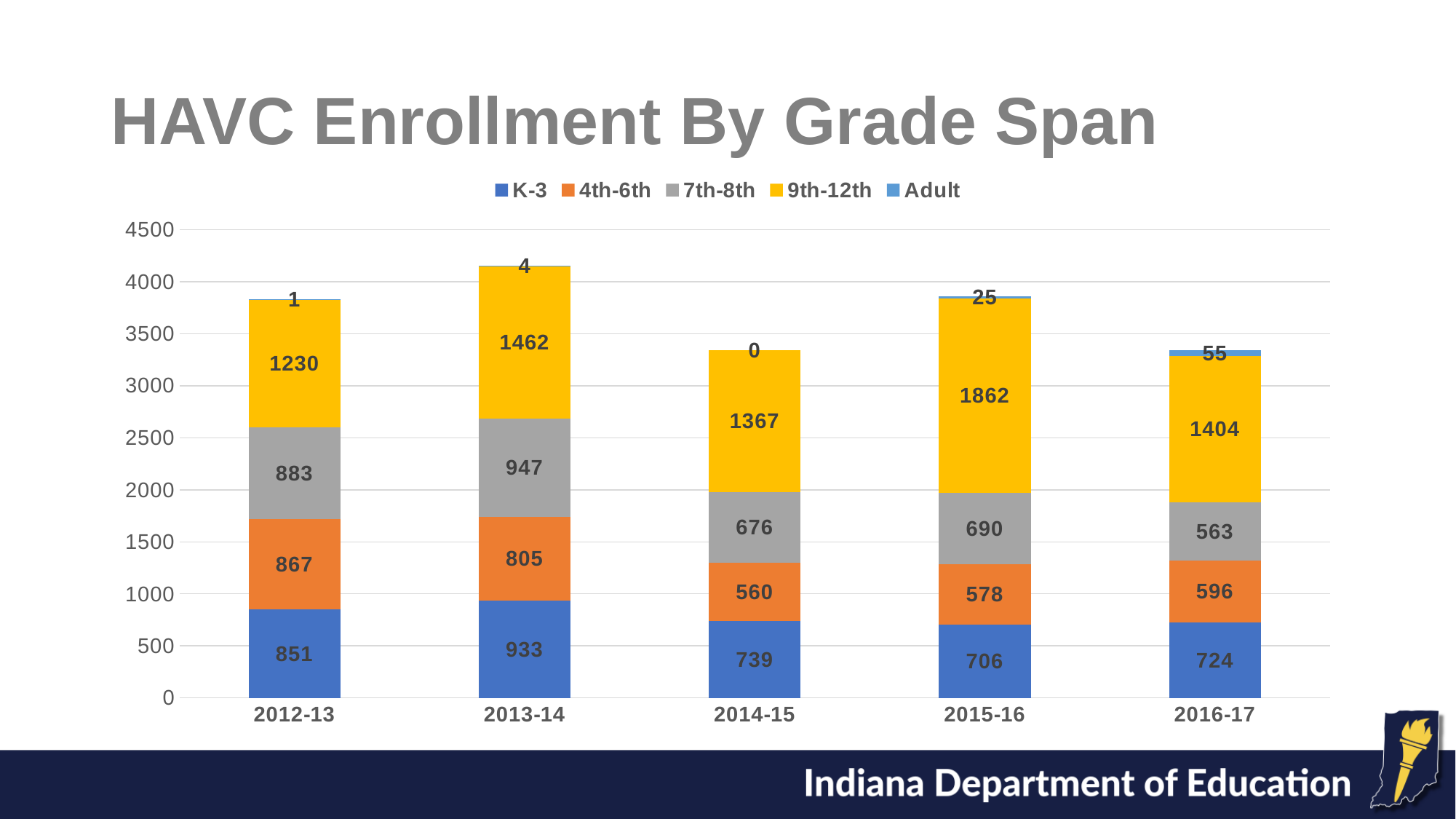
Which is larger, the 7th-8th enrollment in 2013-14 or in 2016-17? 2013-14 What is the total enrollment for 2013-14 across all grade spans? 4151 What is the difference between the 4th-6th enrollment in 2012-13 and in 2014-15? 307 What is the Adult enrollment for 2016-17? 55 How many school years are shown on the x axis? 5 What is the 9th-12th enrollment for 2015-16? 1862 What is the K-3 enrollment for 2013-14? 933 Which year has the lowest K-3 enrollment? 2015-16 What kind of chart is this? Stacked bar chart Which year has the highest 9th-12th enrollment? 2015-16 How many series does the legend list? 5 What is the total enrollment for 2012-13 across all grade spans? 3832